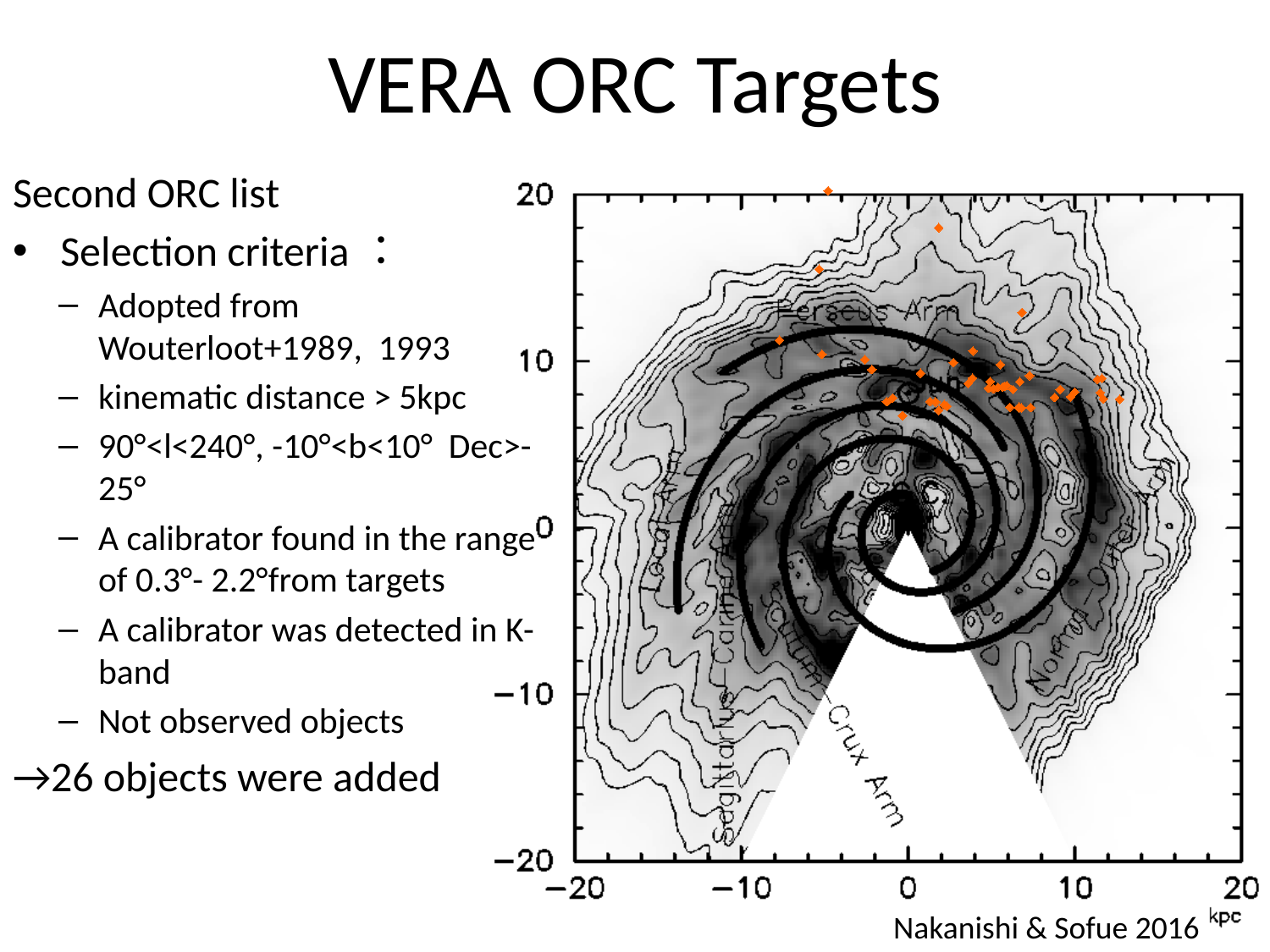
Is the vertical coordinate of the topmost orange point greater or less than 10? greater Is the horizontal coordinate of the leftmost orange point greater or less than 0? less What unit is shown on the axes of the chart? kpc Are the orange points on the chart located at vertical coordinates greater or less than 0? greater Which reference is credited for the background map of the chart? Nakanishi & Sofue 2016 What kind of chart is shown on the slide? scatter plot What is the minimum value shown on the y axis of the chart? -20 What is the maximum value shown on the x axis of the chart? 20